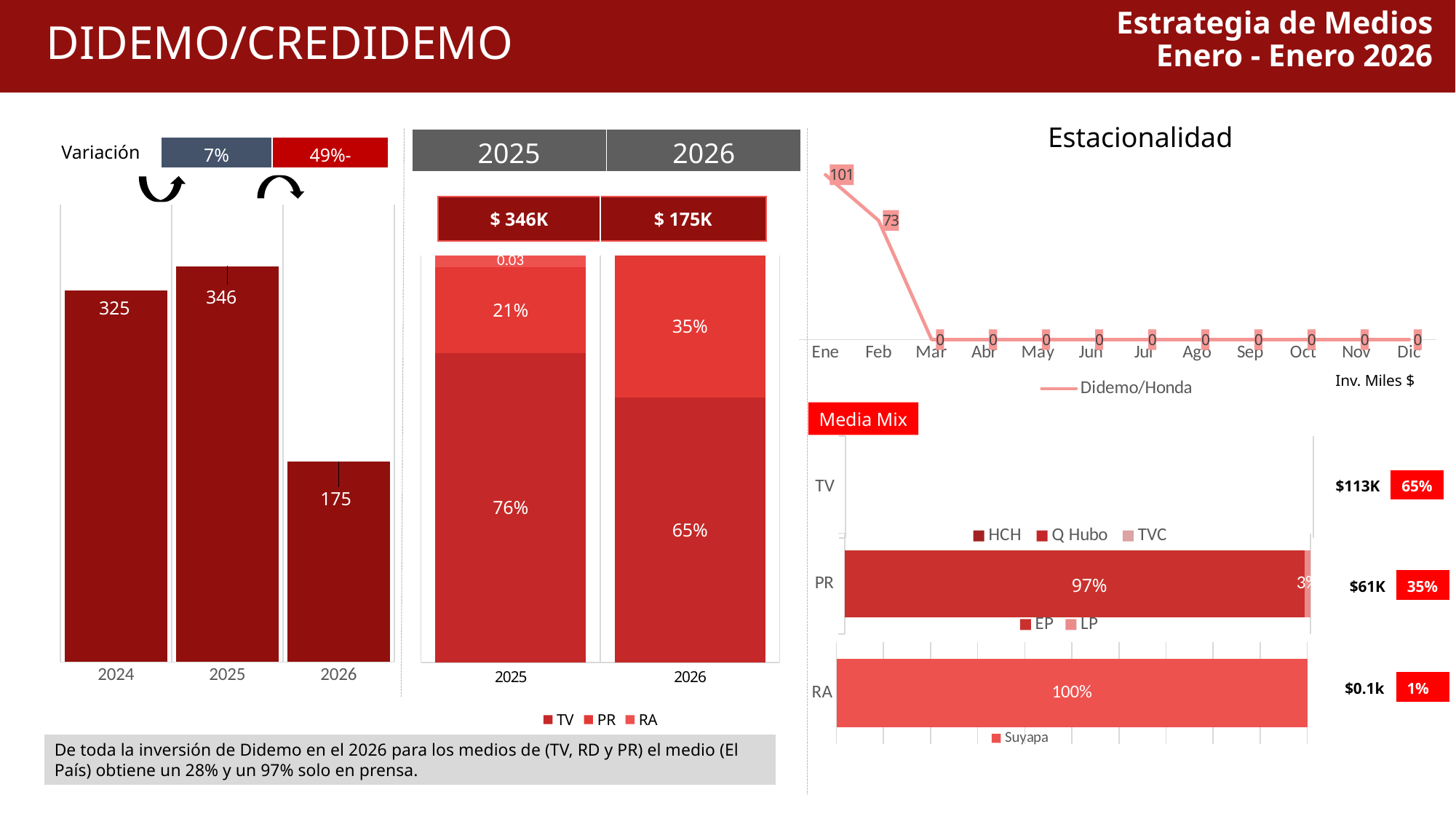
How many series does the legend of the stacked bar chart comparing 2025 and 2026 list? 3 What kind of chart is the Estacionalidad chart? line chart In the Estacionalidad chart, what is the value for Feb? 73 In the Estacionalidad chart, which month has the highest value? Ene In the bar chart on the left showing 2024, 2025 and 2026, is the value for 2024 larger or smaller than the value for 2025? smaller In the bar chart on the left showing 2024, 2025 and 2026, what is the value for 2025? 346 In the Media Mix section, what percentage does EP represent in the PR bar? 97% In the stacked bar chart comparing 2025 and 2026, what percentage does PR represent in 2025? 21% In the bar chart on the left showing 2024, 2025 and 2026, what is the difference between the 2025 and 2026 values? 171 In the stacked bar chart comparing 2025 and 2026, what percentage does TV represent in 2026? 65% In the Media Mix section, what is the name of the series in the legend of the RA bar? Suyapa In the bar chart on the left showing 2024, 2025 and 2026, which year has the lowest value? 2026